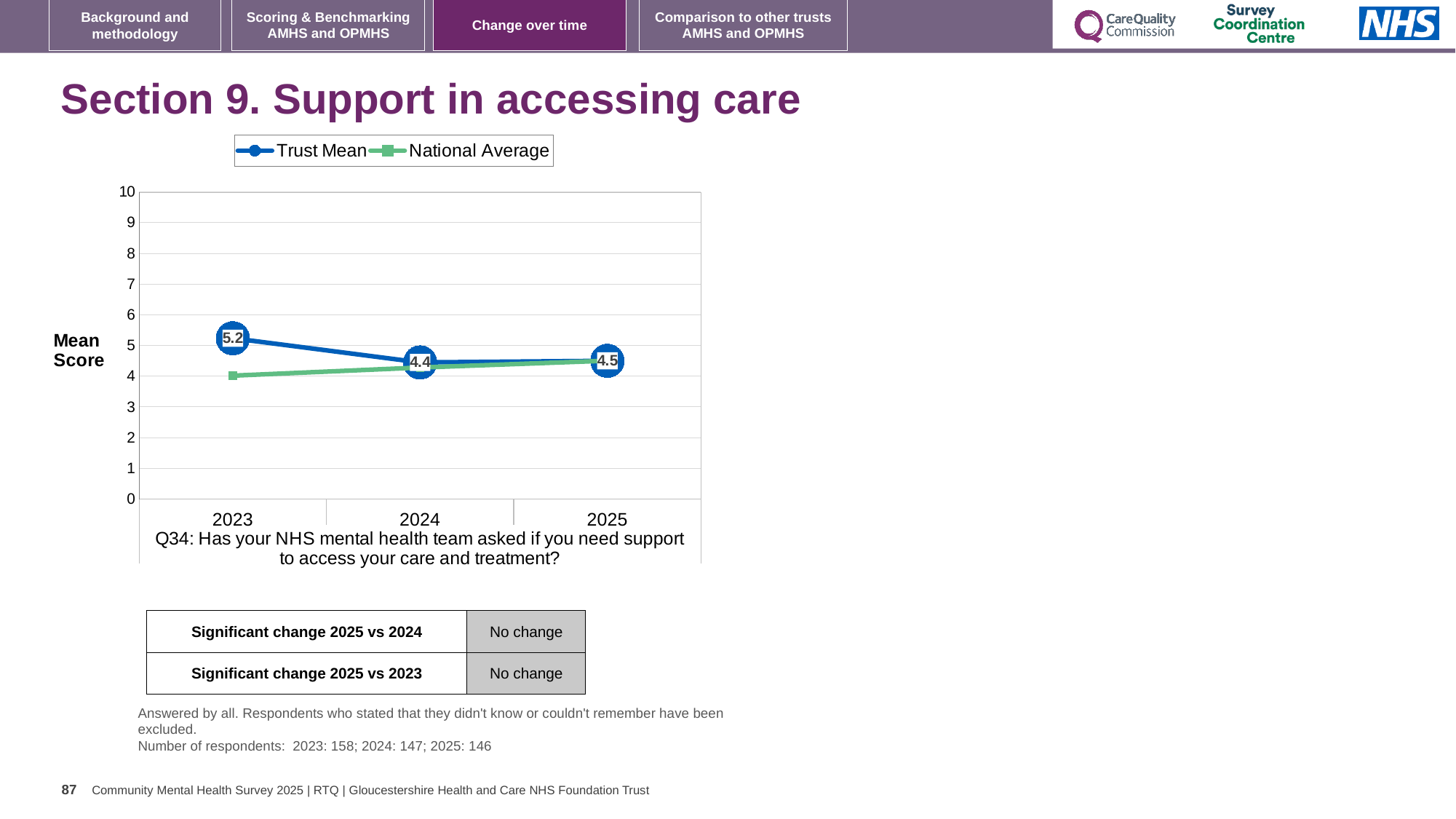
In which year is the Trust Mean highest? 2023 How many series does the legend list? 2 How many years are plotted on the x axis? 3 Between 2023 and 2024, does the Trust Mean rise or fall? fall Which is larger, the Trust Mean in 2023 or in 2025? 2023 What is the Trust Mean value for 2025? 4.5 In which year is the Trust Mean lowest? 2024 What is the difference between the Trust Mean in 2023 and in 2024? 0.8 What is the Trust Mean value for 2024? 4.4 Is the National Average value for 2023 greater or less than 5? less What is the Trust Mean value for 2023? 5.2 What kind of chart is shown on the slide? line chart